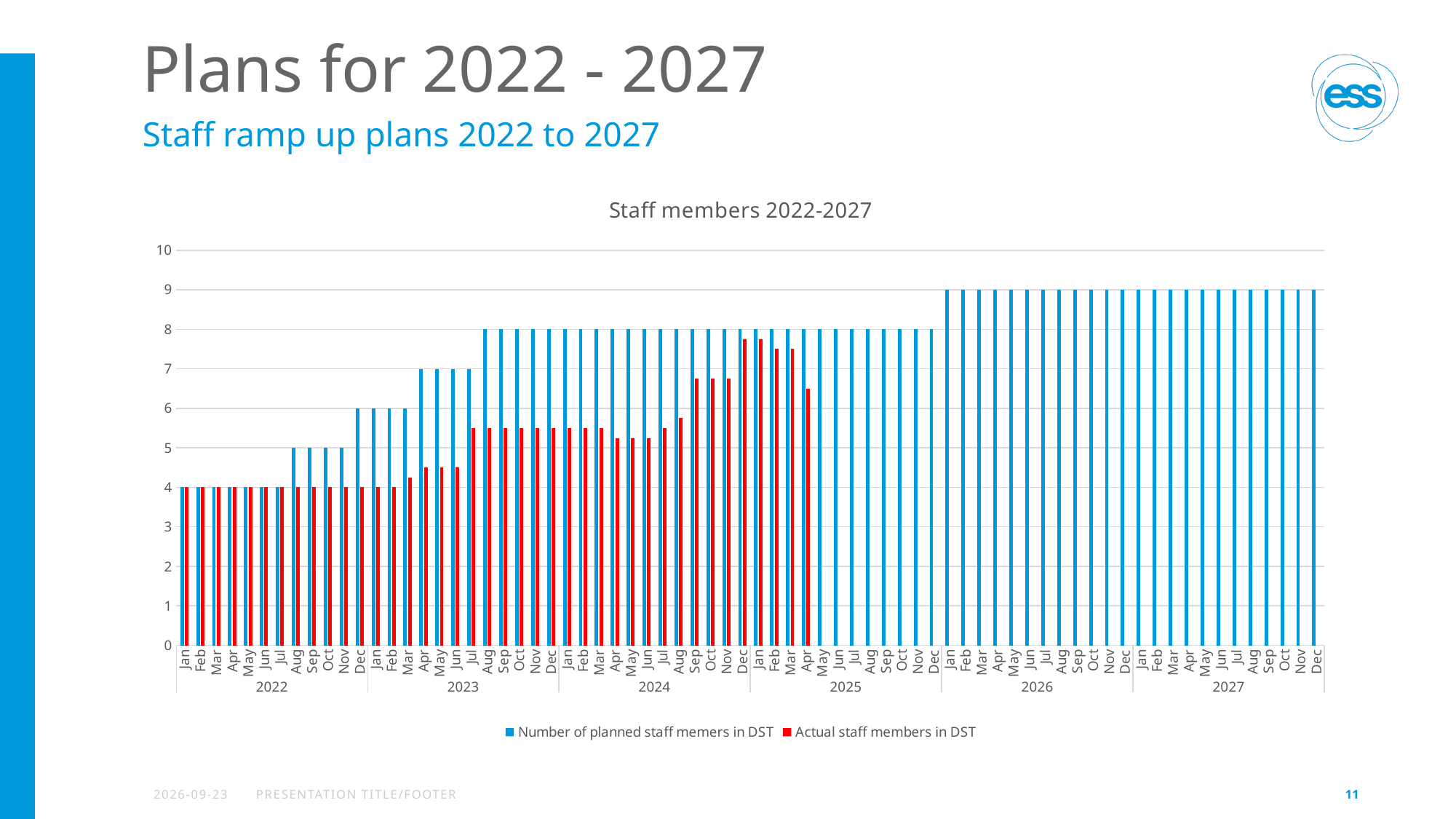
What is the number of planned staff members in DST for Jan 2022? 4 What is the title of the chart? Staff members 2022-2027 What is the number of planned staff members in DST for Aug 2023? 8 What kind of chart is shown on the slide? bar chart What is the highest value reached by the planned staff members series? 9 What is the difference between the planned staff members in Dec 2027 and in Jan 2022? 5 Is the actual number of staff members in DST for Dec 2024 greater or less than 7? greater How many series does the legend list? 2 Do the planned staff member values rise or fall from 2022 to 2027? rise What is the number of planned staff members in DST for Dec 2027? 9 What is the number of planned staff members in DST for Jan 2023? 6 What is the actual number of staff members in DST for Jan 2022? 4